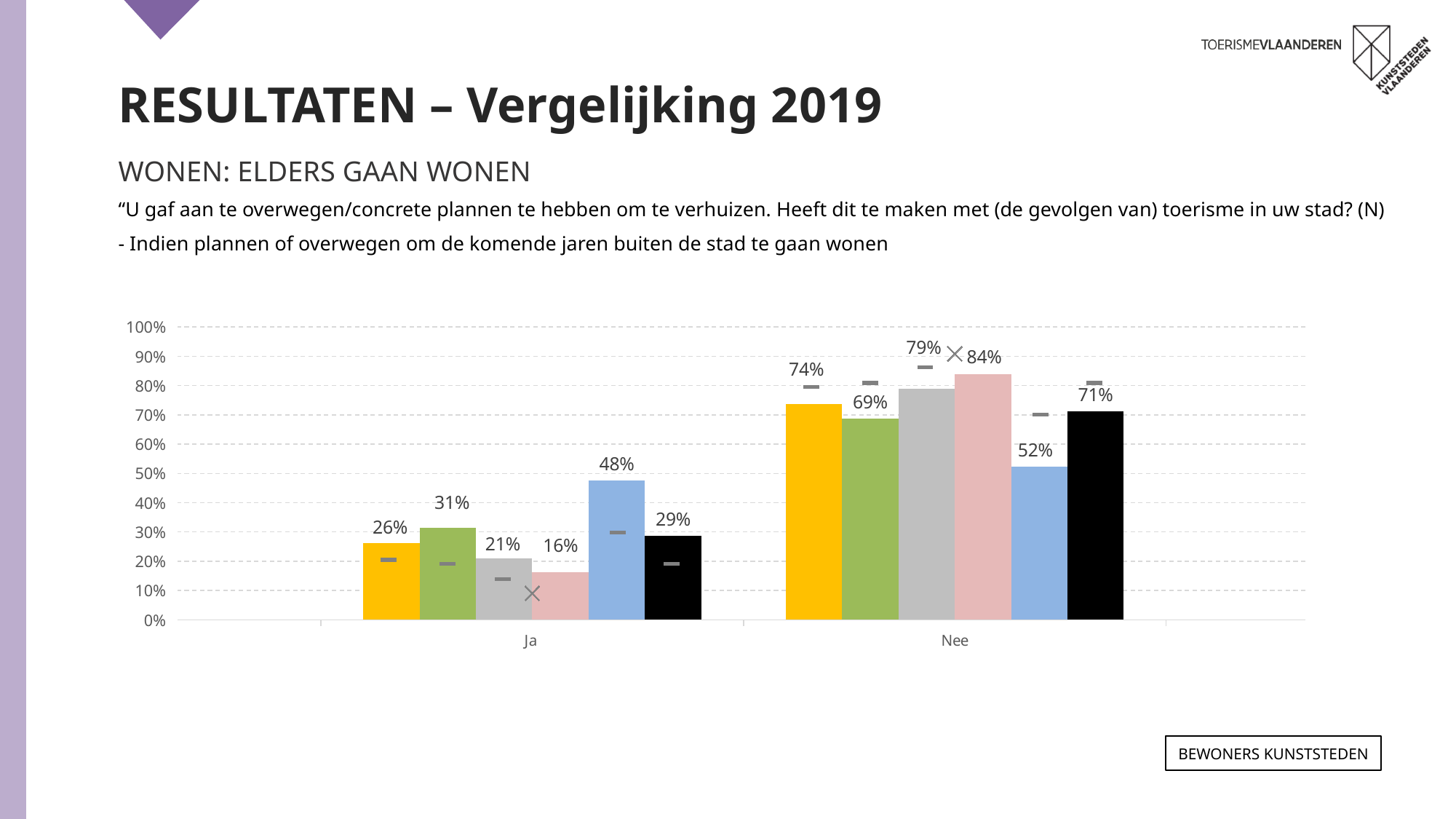
How many categories are shown on the x axis? 2 Which coloured bar has the highest value in the "Nee" category? pink (84%) What value is shown for the yellow bar in the "Ja" category? 26% What value is shown for the black bar in the "Nee" category? 71% What value is shown for the blue bar in the "Nee" category? 52% What kind of chart is shown on the slide? bar chart Which coloured bar has the lowest value in the "Ja" category? pink (16%) What is the difference between the blue bar and the pink bar in the "Ja" category? 32 percentage points Which is larger in the "Nee" category: the yellow bar or the green bar? the yellow bar (74%) What value is shown for the pink bar in the "Ja" category? 16% What is the maximum value shown on the y axis? 100% Is the value of the grey bar in the "Nee" category greater or less than 70%? greater